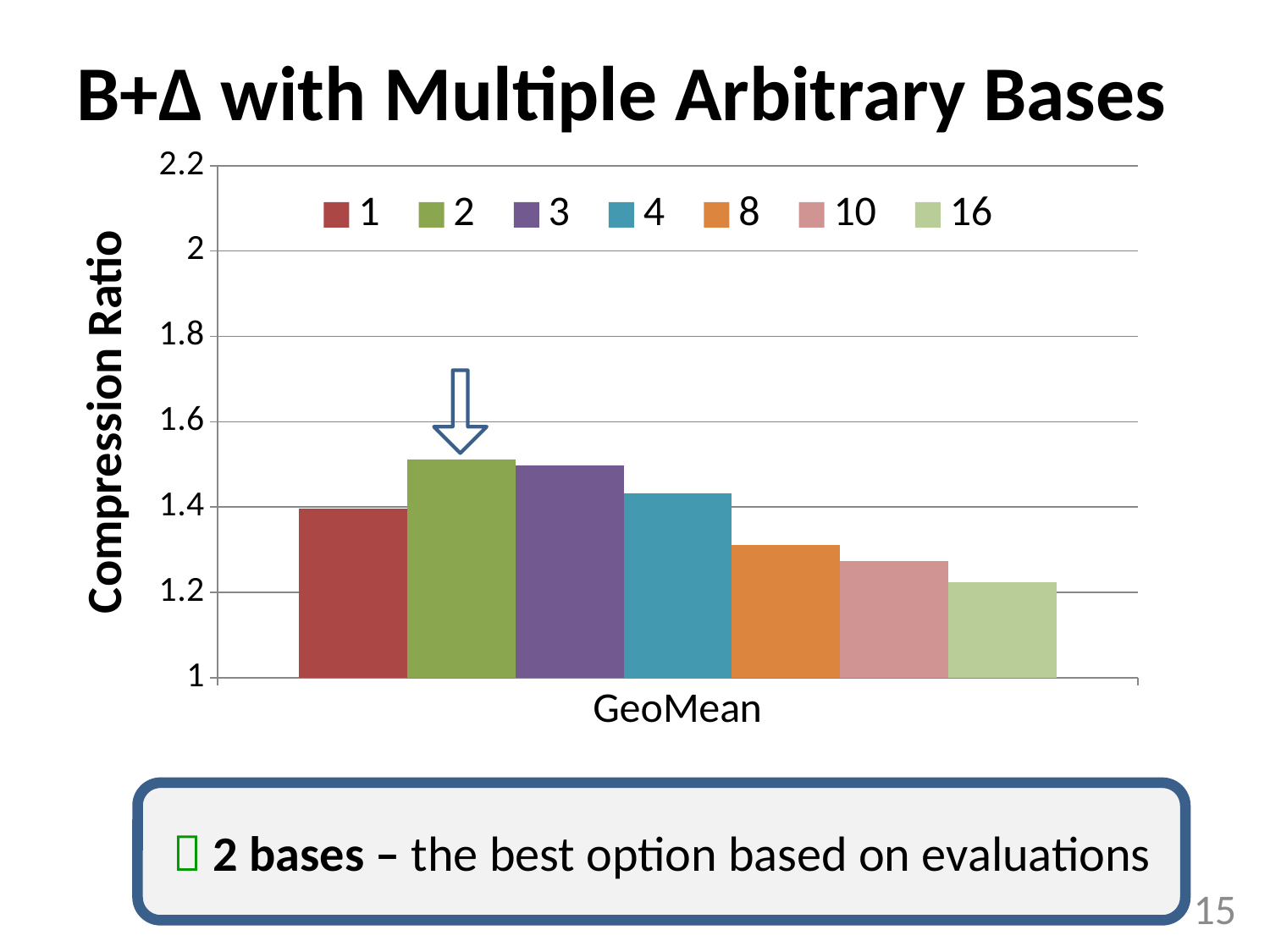
Is the value for series 2 greater or less than 1.4? greater What is the title of the y axis? Compression Ratio Is the value for series 8 greater or less than 1.4? less How many categories are shown on the x axis? 1 Is the value for series 16 greater or less than 1.2? greater Which series has the lowest compression ratio? 16 How many series does the legend list? 7 Which is larger, the value for series 1 or the value for series 10? 1 What kind of chart is shown on the slide? bar chart Which is larger, the value for series 4 or the value for series 8? 4 Which series has the highest compression ratio? 2